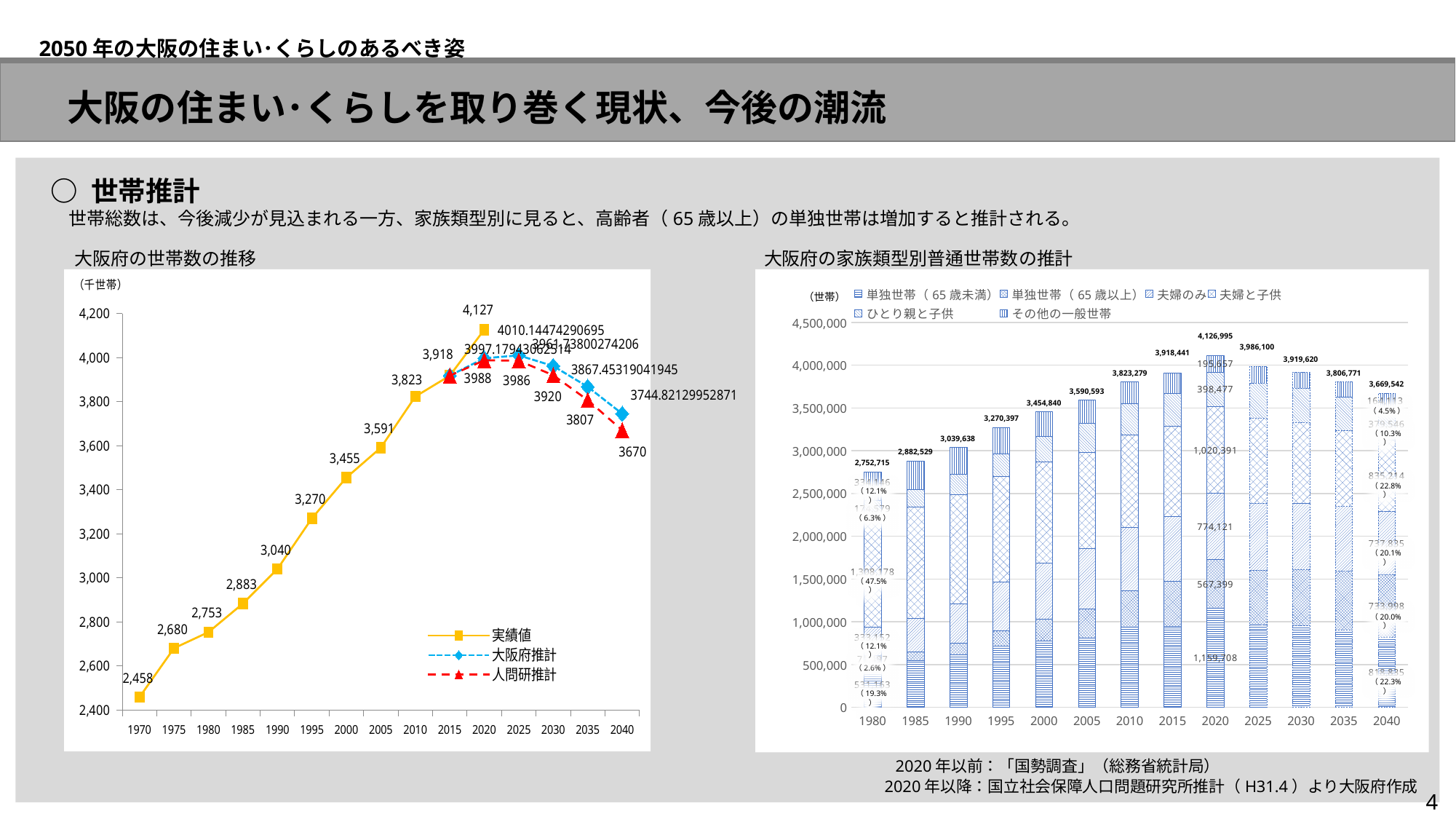
In the left chart 大阪府の世帯数の推移, what is the 人問研推計 value for 2035? 3807 In the right chart 大阪府の家族類型別普通世帯数の推計, which year has the lowest total? 1980 In the right chart 大阪府の家族類型別普通世帯数の推計, which year has the highest total? 2020 How many years are shown on the x axis of the right chart 大阪府の家族類型別普通世帯数の推計? 13 In the right chart 大阪府の家族類型別普通世帯数の推計, what is the total for 2040? 3,669,542 How many series does the legend of the right chart 大阪府の家族類型別普通世帯数の推計 list? 6 In the left chart 大阪府の世帯数の推移, what is the 実績値 value for 1970? 2,458 In the left chart 大阪府の世帯数の推移, what is the 実績値 value for 2020? 4,127 How many series does the legend of the left chart 大阪府の世帯数の推移 list? 3 What kind of chart is the left chart titled 大阪府の世帯数の推移? line chart In the left chart 大阪府の世帯数の推移, what is the 人問研推計 value for 2040? 3670 In the left chart 大阪府の世帯数の推移, what is the difference between the 実績値 values for 2020 and 2015? 209